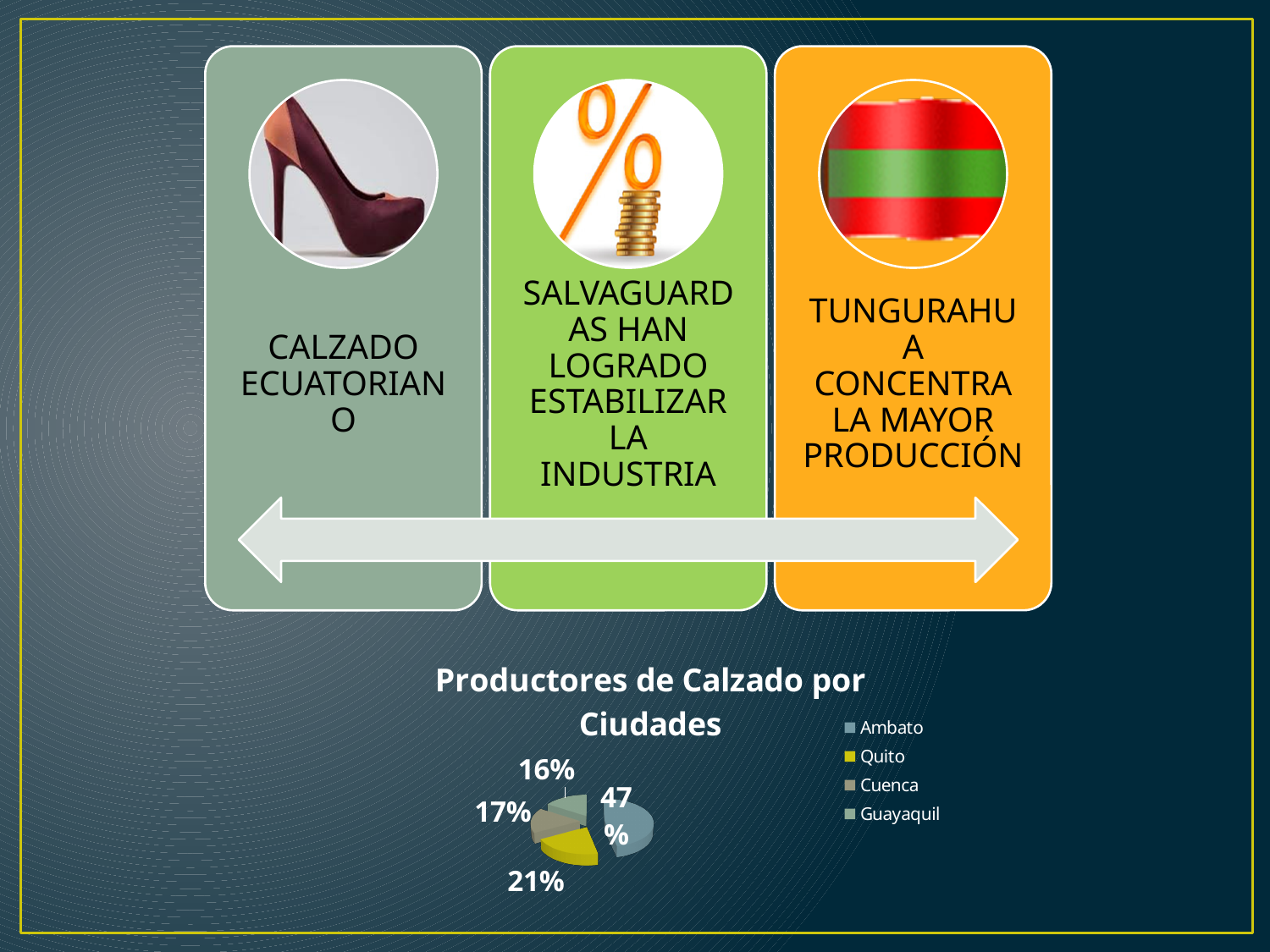
In the pie chart "Productores de Calzado por Ciudades", what share does Guayaquil have? 16% In the pie chart "Productores de Calzado por Ciudades", what is the difference between Ambato's share and Quito's share? 26% What kind of chart is shown under the title "Productores de Calzado por Ciudades"? pie chart In the pie chart "Productores de Calzado por Ciudades", what share does Cuenca have? 17% In the pie chart "Productores de Calzado por Ciudades", what share does Ambato have? 47% How many cities are shown in the pie chart "Productores de Calzado por Ciudades"? 4 Which city has the smallest slice in the pie chart "Productores de Calzado por Ciudades"? Guayaquil In the pie chart "Productores de Calzado por Ciudades", what share does Quito have? 21% In the pie chart "Productores de Calzado por Ciudades", which has a larger share, Quito or Cuenca? Quito Which city has the largest slice in the pie chart "Productores de Calzado por Ciudades"? Ambato How many entries does the legend of the pie chart "Productores de Calzado por Ciudades" list? 4 What is the title of the pie chart on the slide? Productores de Calzado por Ciudades